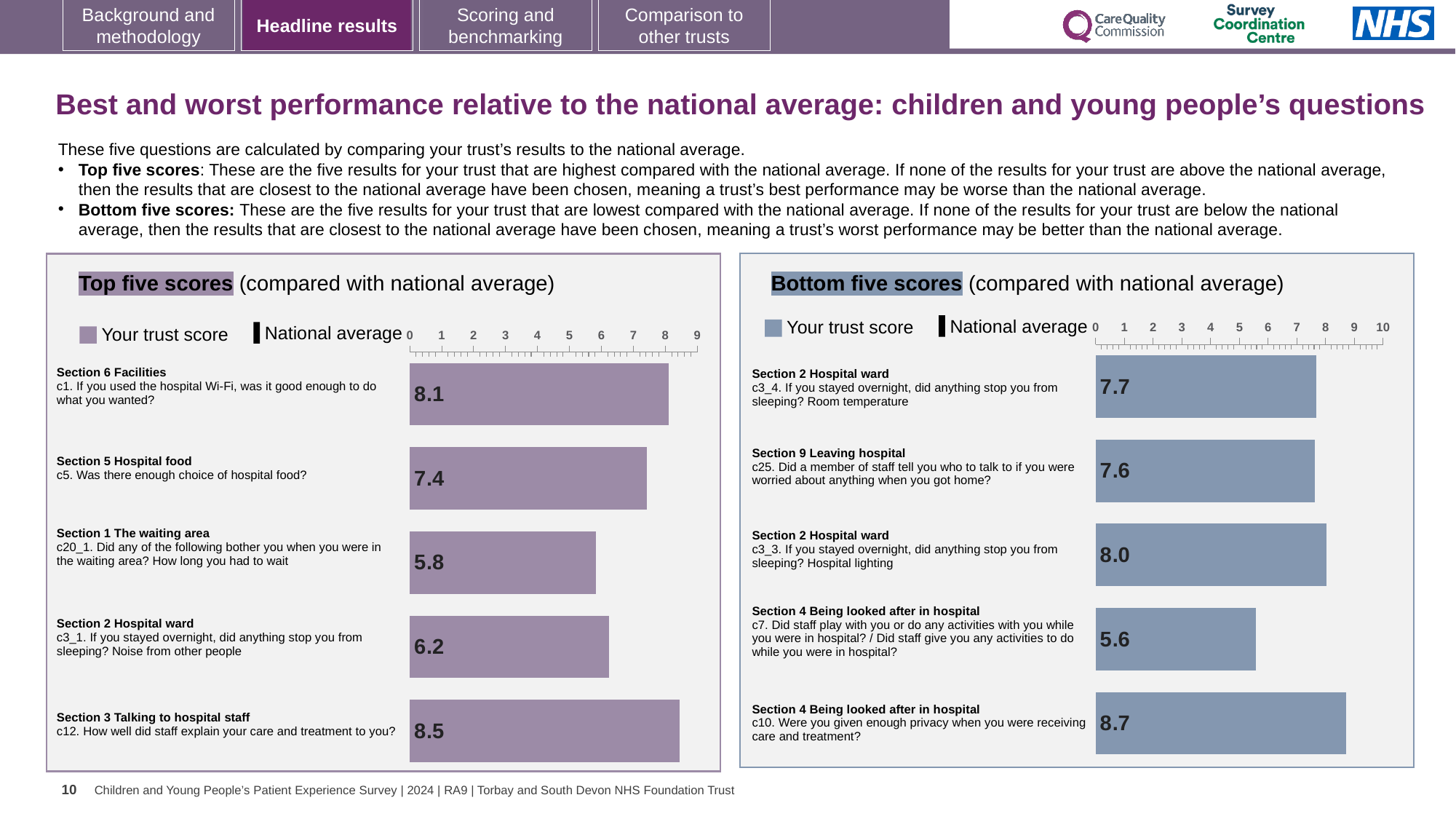
In the Top five scores chart, what is the trust score for c1 (hospital Wi-Fi)? 8.1 How many entries does the legend of the Bottom five scores chart list? 2 In the Bottom five scores chart, what is the trust score for c10 (enough privacy when receiving care and treatment)? 8.7 In the Bottom five scores chart, which question has the lowest trust score? c7. Did staff play with you or do any activities with you while you were in hospital? In the Bottom five scores chart, what is the trust score for c7 (staff play with you or do activities)? 5.6 In the Top five scores chart, which has the larger trust score: c3_1 (noise from other people) or c20_1 (how long you had to wait)? c3_1 (noise from other people) What type of chart is the Top five scores chart? Bar chart In the Top five scores chart, what is the trust score for c5 (enough choice of hospital food)? 7.4 In the Top five scores chart, which question has the highest trust score? c12. How well did staff explain your care and treatment to you? In the Top five scores chart, which question has the lowest trust score? c20_1. Did any of the following bother you when you were in the waiting area? How long you had to wait How many questions are plotted in the Bottom five scores chart? 5 In the Bottom five scores chart, what is the difference between the trust scores for c10 (privacy) and c7 (staff play/activities)? 3.1